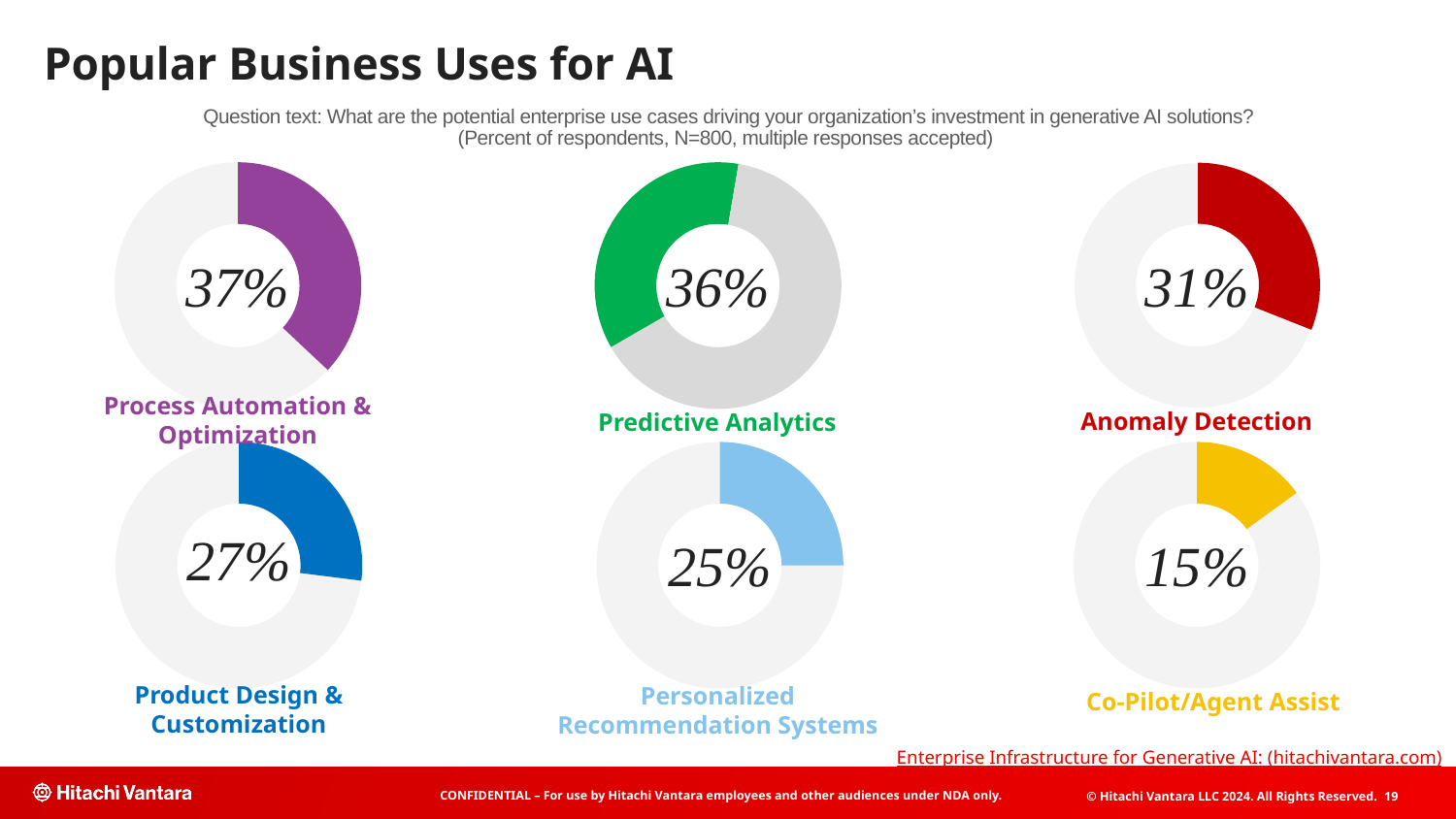
Which use case has the highest percentage across the six donut charts? Process Automation & Optimization What percentage is shown for Anomaly Detection? 31% What value is shown for Product Design & Customization? 27% What percentage of respondents selected Co-Pilot/Agent Assist? 15% What percentage of respondents selected Process Automation & Optimization? 37% What colour is the filled segment of the Predictive Analytics donut chart? Green What is the difference in percentage points between Anomaly Detection and Co-Pilot/Agent Assist? 16 Which has a higher percentage, Product Design & Customization or Personalized Recommendation Systems? Product Design & Customization What value is shown in the Predictive Analytics donut chart? 36% How many use cases are shown as donut charts on the slide? 6 Which use case has the lowest percentage across the six donut charts? Co-Pilot/Agent Assist What kind of chart is used to display each use case's percentage? Donut chart